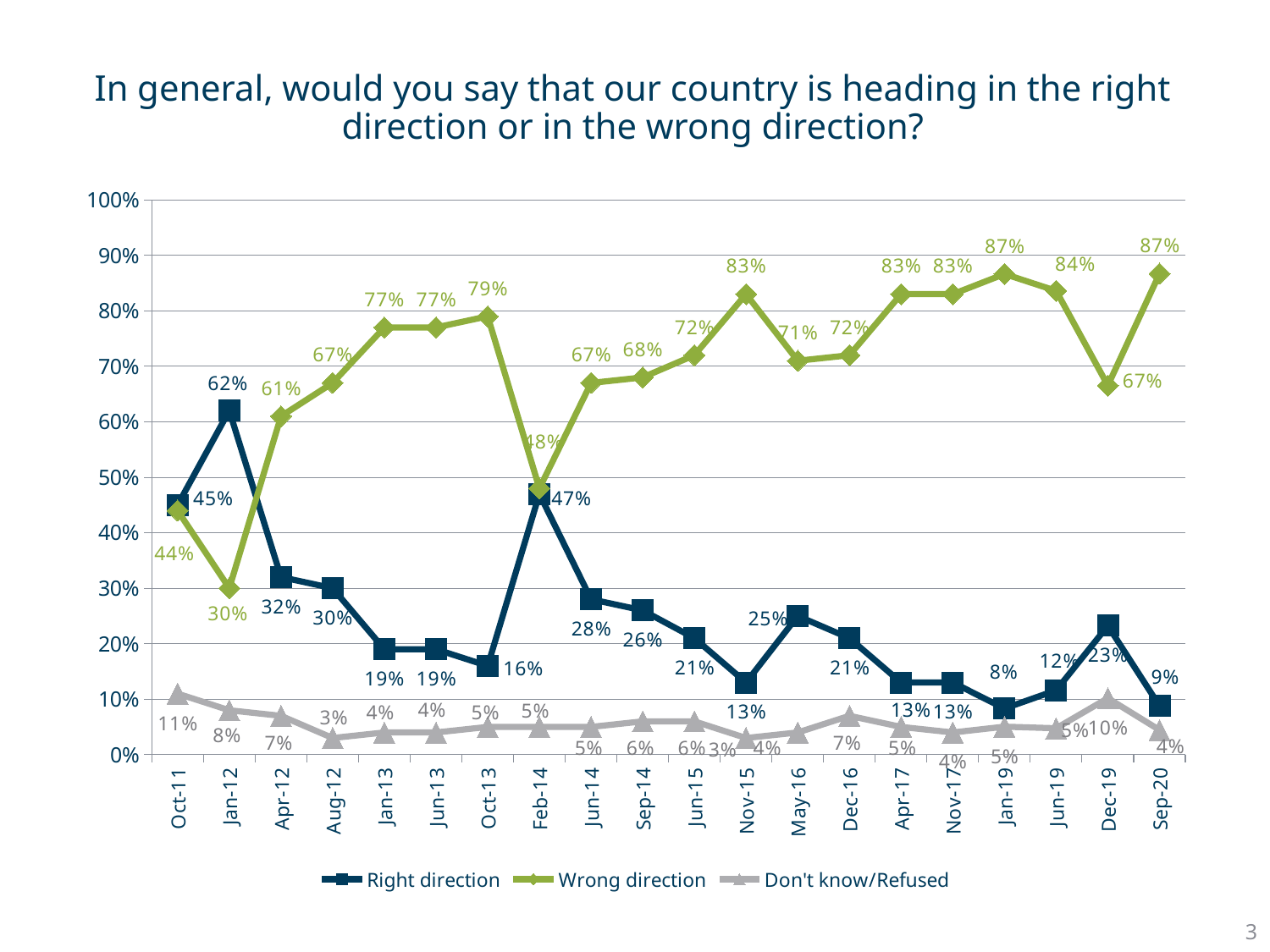
What kind of chart is shown on the slide? Line chart What is the value for Right direction in Jan-12? 62% In Sep-20, how much higher is Wrong direction than Right direction? 78 percentage points In which period is the Right direction value lowest? Jan-19 What is the value for Don't know/Refused in Dec-19? 10% In which period is the Wrong direction value lowest? Jan-12 How many series does the legend list? 3 In Nov-15, which is larger: Right direction or Wrong direction? Wrong direction What is the value for Wrong direction in Oct-13? 79% What is the value for Don't know/Refused in Oct-11? 11% How many time periods are shown on the x axis? 20 In which period is the Right direction value highest? Jan-12